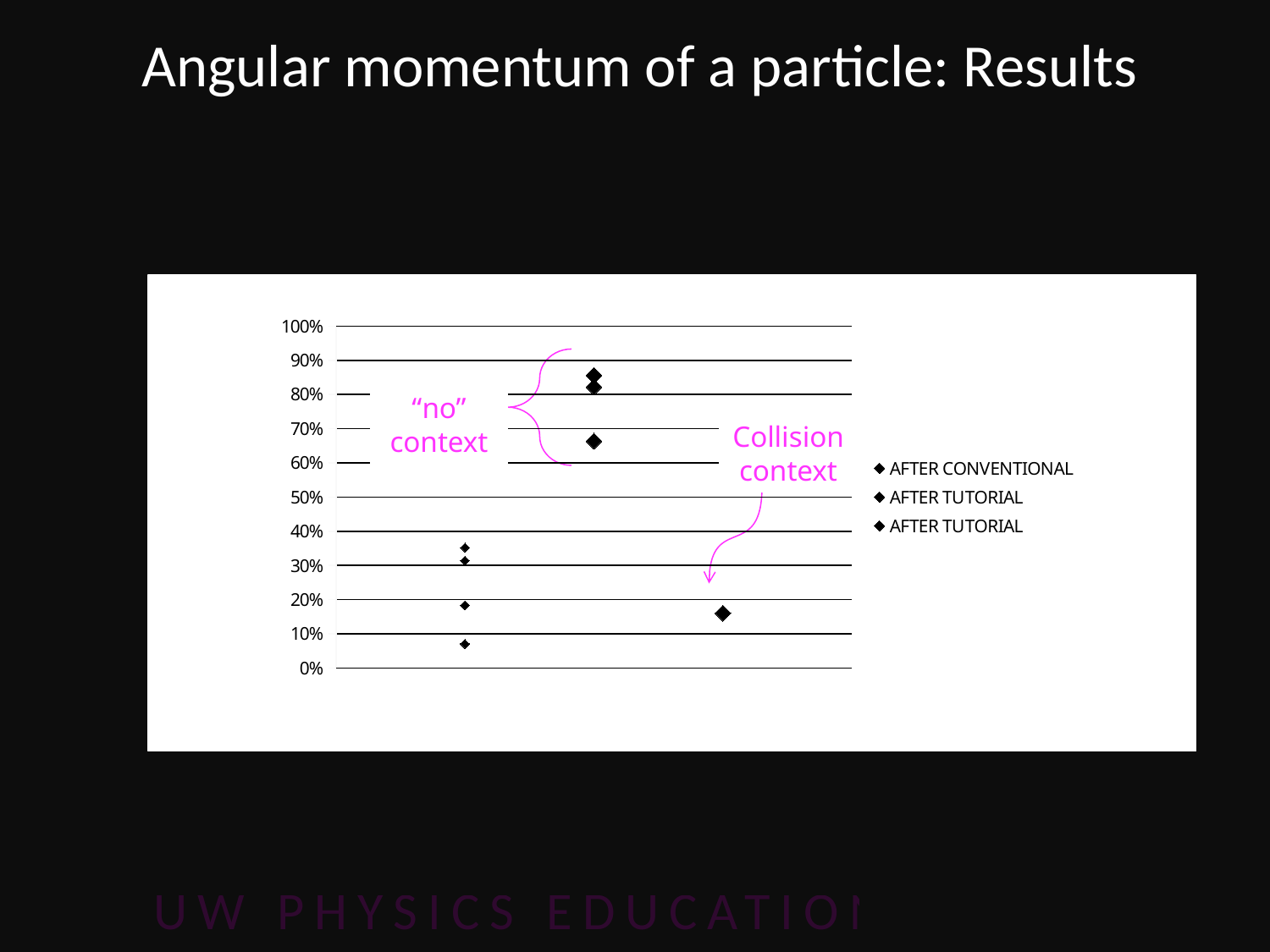
Is the lowest point on the chart greater or less than 10%? less Is the highest point in the leftmost cluster of points greater or less than 40%? less Is the highest point on the chart greater or less than 80%? greater Which group of points is higher on the chart: the points in the "no" context bracket or the point indicated by the "Collision context" arrow? the "no" context points What kind of chart is shown on the slide? scatter chart What is the first entry in the chart's legend? AFTER CONVENTIONAL How many series does the chart's legend list? 3 How many data points are plotted on the chart in total? 8 What is the highest value shown on the chart's vertical axis? 100% How many data points are enclosed by the bracket labelled "no" context? 3